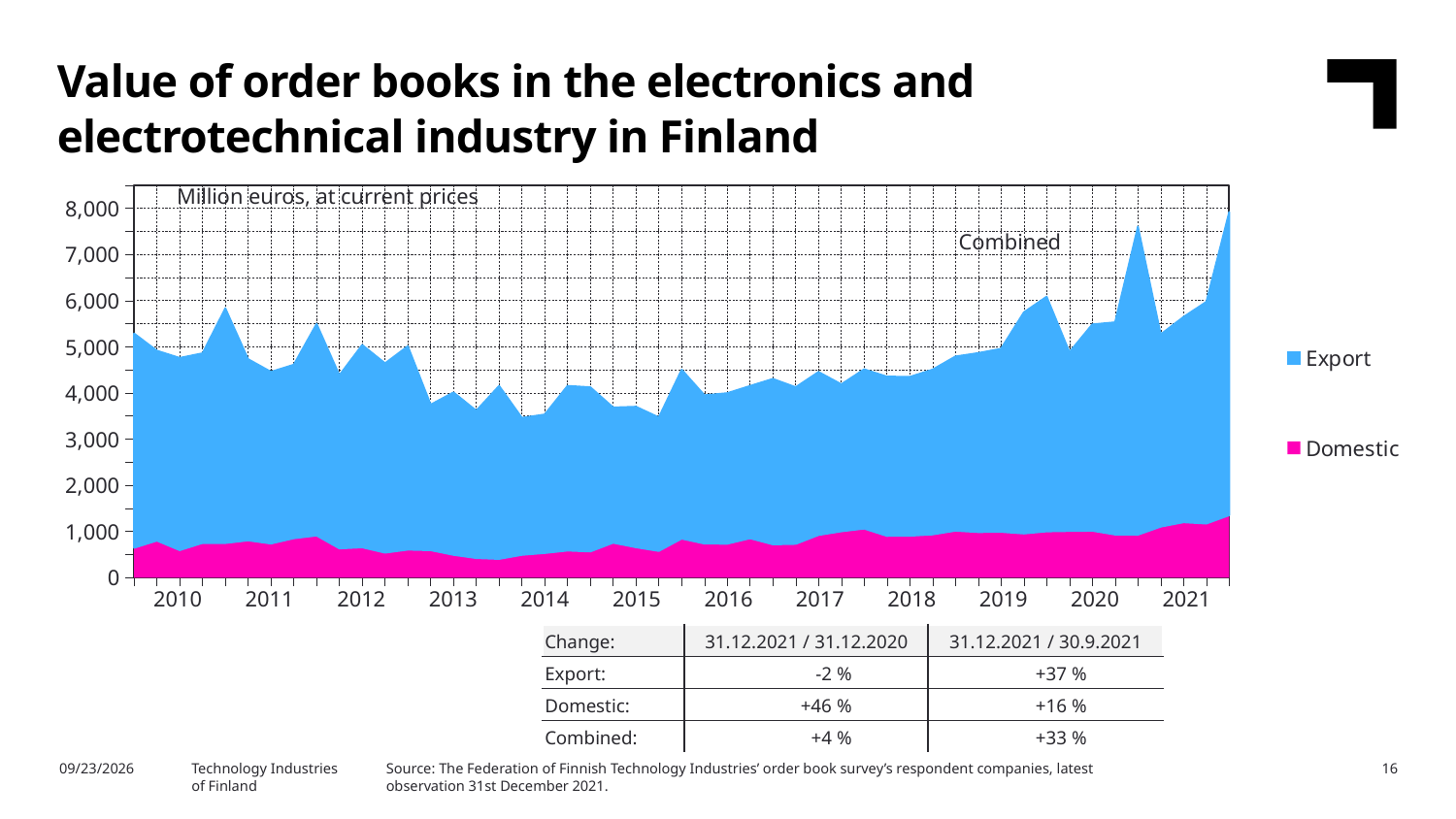
Is the Domestic value during 2013 greater or less than 1,000? less How many series does the chart legend list? 2 Is the Domestic value at the end of 2021 greater or less than 1,000? greater Is the combined value of order books during 2016 greater or less than 5,000? less How many year labels are shown on the x axis of the chart? 12 Which two series are listed in the chart legend? Export and Domestic Does the combined value of order books generally rise or fall from 2010 to 2014? fall What kind of chart is shown on the slide? Stacked area chart What unit is stated for the values on the chart? Million euros, at current prices Does the Domestic series generally rise or fall from 2013 to 2021? rise